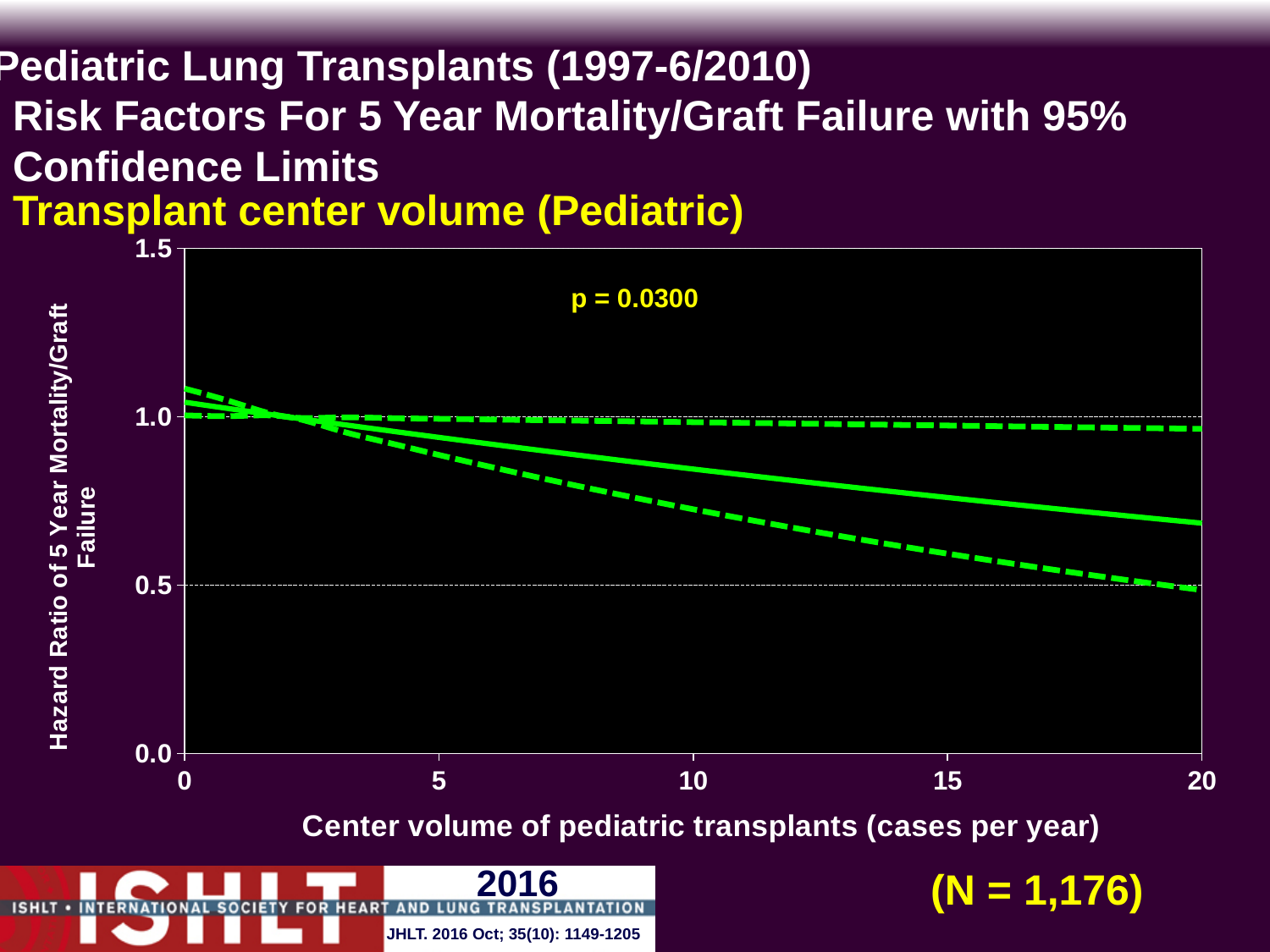
What kind of chart is shown on the slide? line chart Does the solid hazard ratio line rise or fall as center volume increases from 0 to 20 cases per year? fall Is the hazard ratio on the solid line at a center volume of 20 cases per year greater or less than 0.5? greater How many lines are plotted on the chart? 3 What p-value is printed on the chart? p = 0.0300 Is the lower dashed confidence limit at a center volume of 15 cases per year greater or less than 0.5? greater What is the highest value shown on the y axis of the chart? 1.5 Is the hazard ratio on the solid line at a center volume of 10 cases per year greater or less than 1.0? less